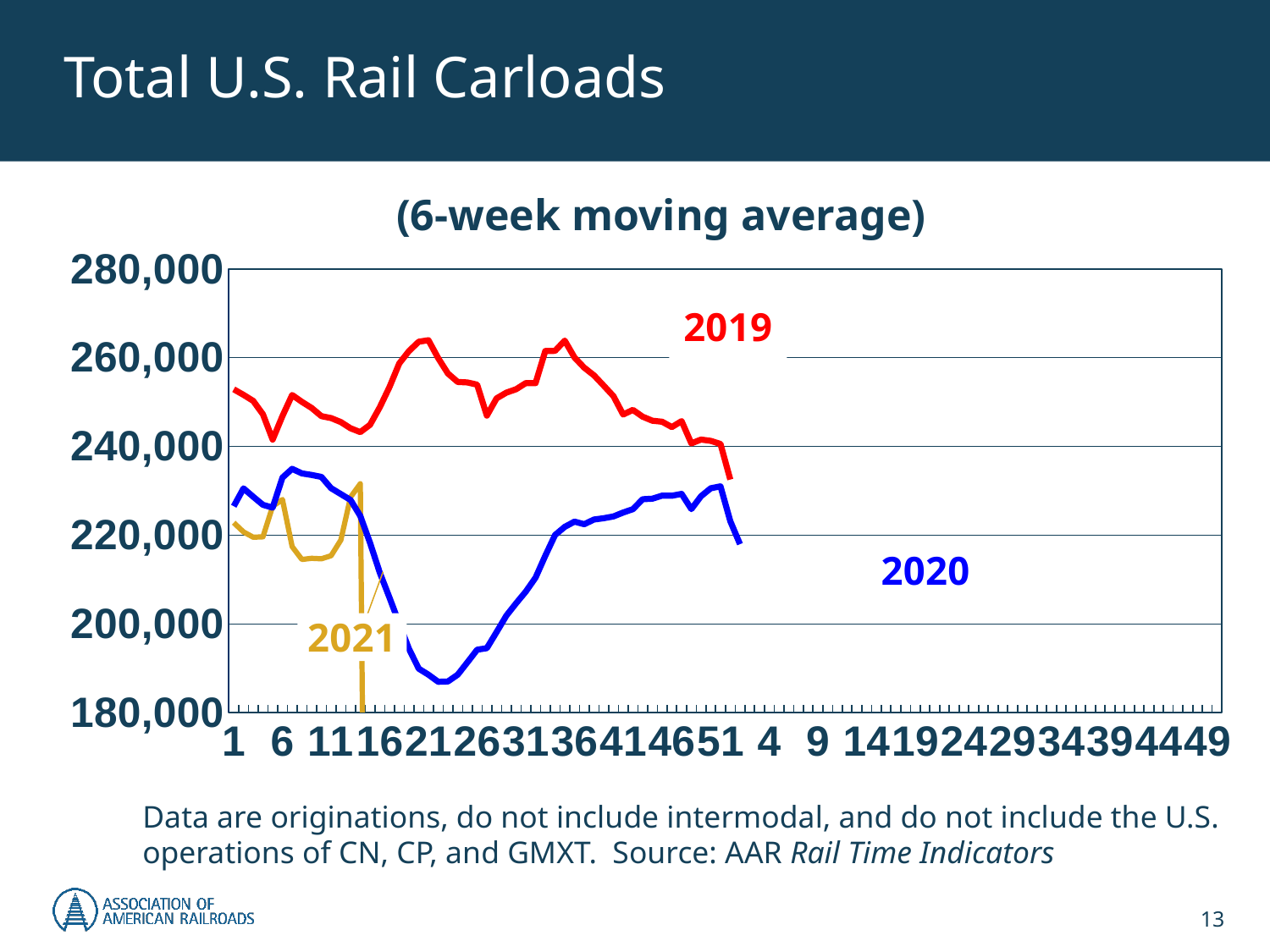
Is the lowest point of the 2020 line greater or less than 200,000? less Does the 2020 line rise or fall between week 21 and week 36? rise Does the 2019 line rise or fall between week 41 and week 51? fall Which colour is used for the 2020 line? blue What is the subtitle shown above the chart? (6-week moving average) How many data series (years) are plotted on the chart? 3 Is the highest point of the 2019 line greater or less than 260,000? greater What kind of chart is shown on the slide? line chart Is the 2021 value at week 11 greater or less than 220,000? less At week 21, which line is higher, 2019 or 2020? 2019 Which year's line is highest across the chart? 2019